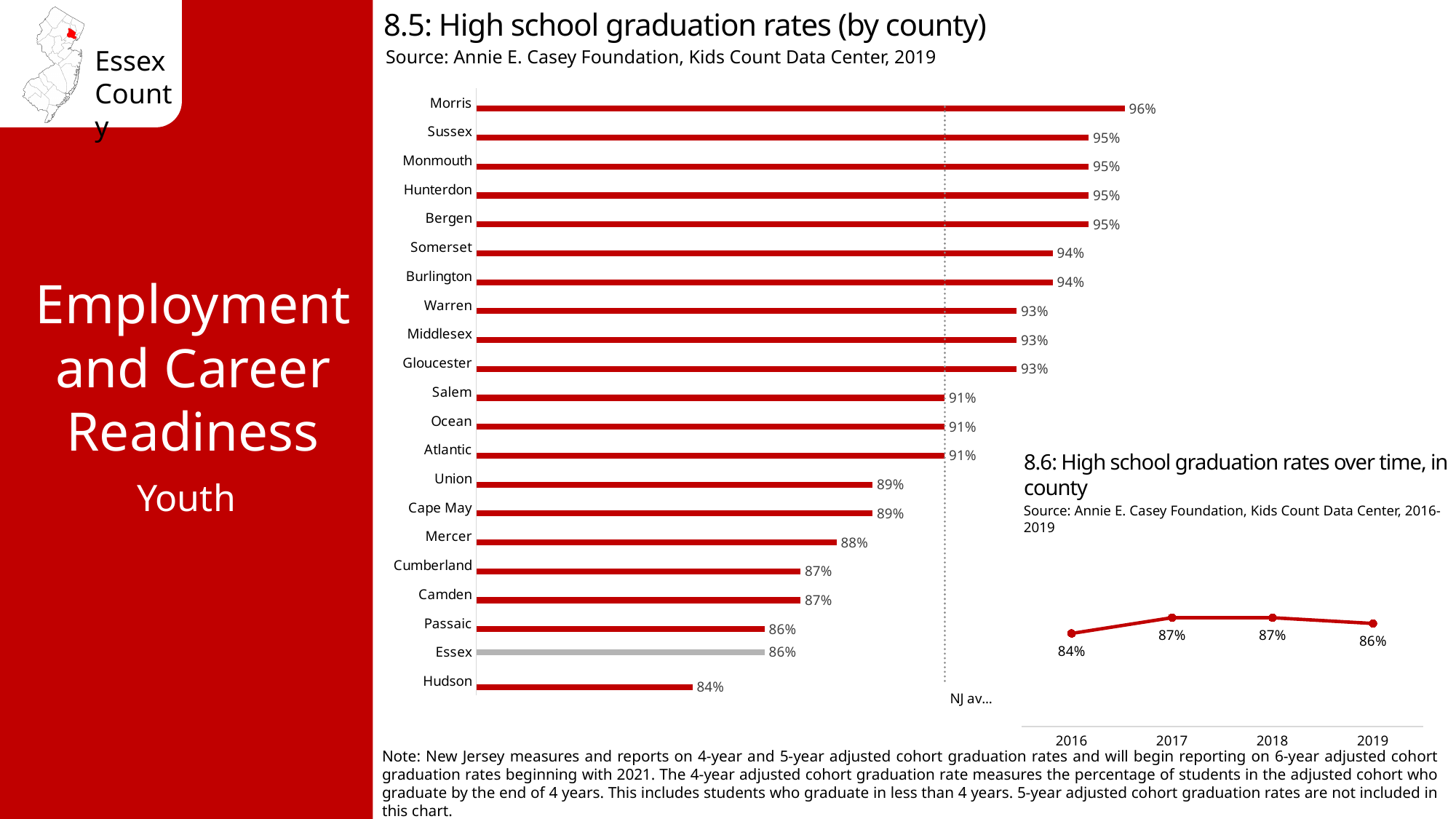
In chart 8.5 (High school graduation rates by county), what is the graduation rate for Essex? 86% In chart 8.5 (High school graduation rates by county), how many counties are shown? 21 What kind of chart is chart 8.6 (High school graduation rates over time, in county)? Line chart In chart 8.5 (High school graduation rates by county), which county has the lowest graduation rate? Hudson In chart 8.5 (High school graduation rates by county), which county has the highest graduation rate? Morris In chart 8.6 (High school graduation rates over time, in county), which year had the lowest graduation rate? 2016 In chart 8.5 (High school graduation rates by county), what is the difference between the graduation rates of Morris and Hudson? 12 percentage points What kind of chart is chart 8.5 (High school graduation rates by county)? Bar chart In chart 8.6 (High school graduation rates over time, in county), what was the graduation rate in 2016? 84% In chart 8.5 (High school graduation rates by county), what is the graduation rate for Somerset? 94% In chart 8.6 (High school graduation rates over time, in county), what is the difference between the 2017 and 2016 graduation rates? 3 percentage points In chart 8.5 (High school graduation rates by county), which has a higher graduation rate, Union or Mercer? Union